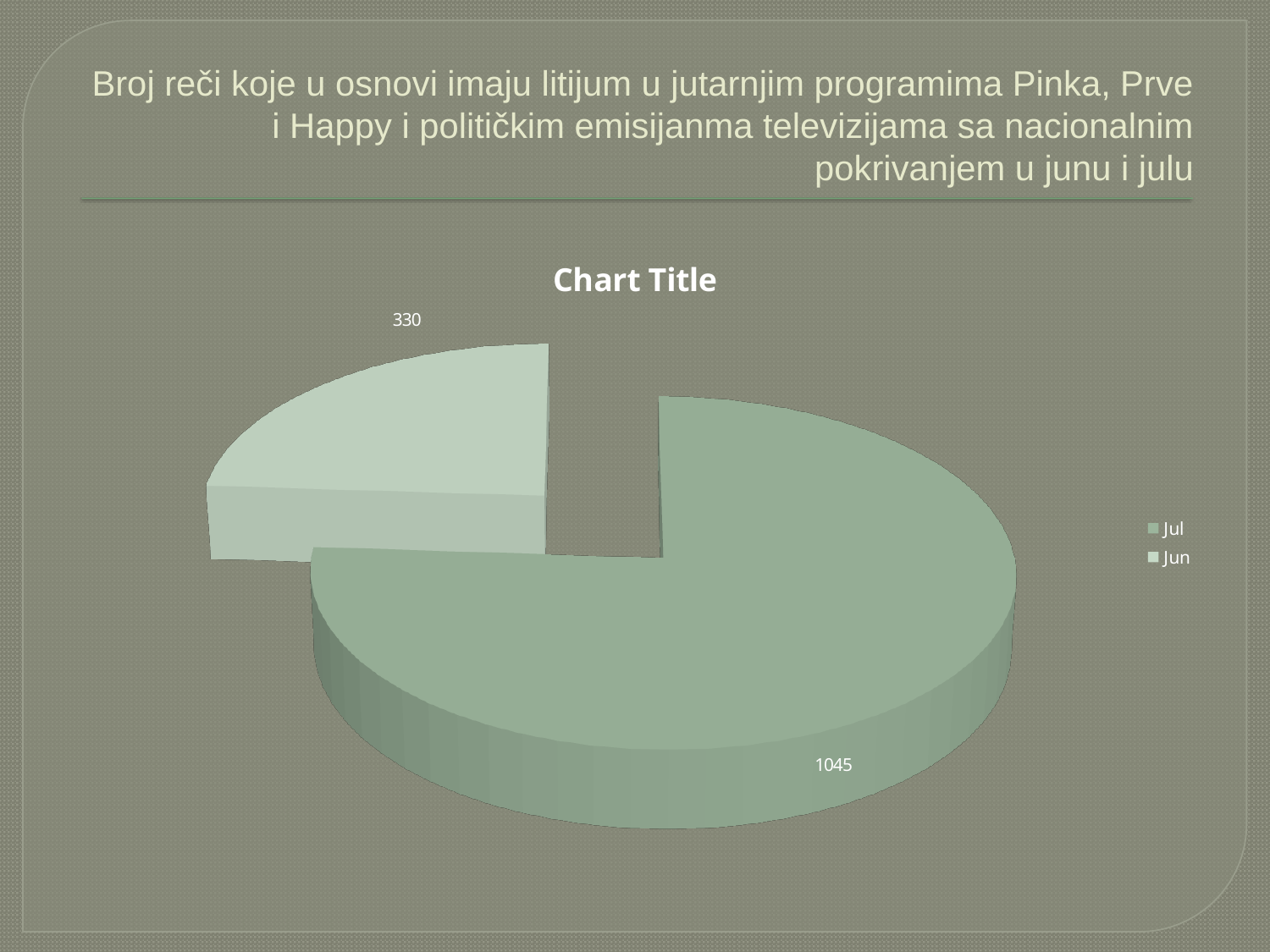
Is the value for Jul larger or smaller than the value for Jun? larger What is the total of the two slices in the pie chart? 1375 What is the value for Jun in the pie chart? 330 Which month has the larger slice in the pie chart? Jul How many slices does the pie chart have? 2 What is the difference between the values for Jul and Jun? 715 Which month has the smaller slice in the pie chart? Jun What share of the pie does the Jun slice represent, to the nearest whole percent? 24% What kind of chart is shown on the slide? pie chart What is the title printed above the pie chart? Chart Title What is the value for Jul in the pie chart? 1045 How many entries does the legend list? 2